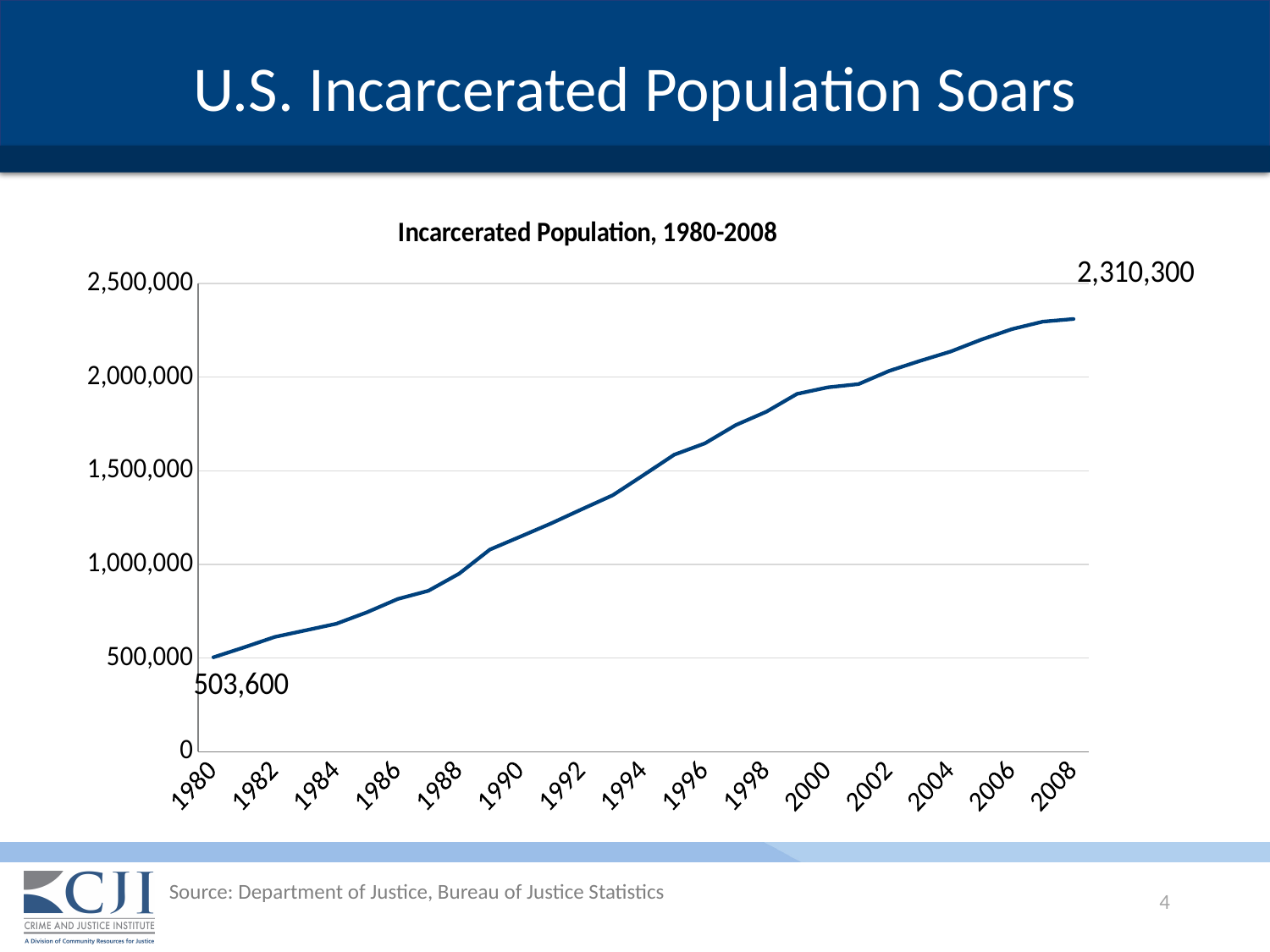
How many year labels are shown on the x axis? 15 What is the incarcerated population value labeled for 2008? 2,310,300 What is the title of the chart? Incarcerated Population, 1980-2008 What is the difference between the 2008 value and the 1980 value? 1,806,700 What is the incarcerated population value labeled for 1980? 503,600 Is the value for 1990 greater or less than 1,000,000? greater Which year has the lowest incarcerated population on the chart? 1980 Which year has the highest incarcerated population on the chart? 2008 What type of chart is shown on the slide? line chart Does the incarcerated population rise or fall from 1980 to 2008? rise Which is larger, the value for 2008 or the value for 1980? 2008